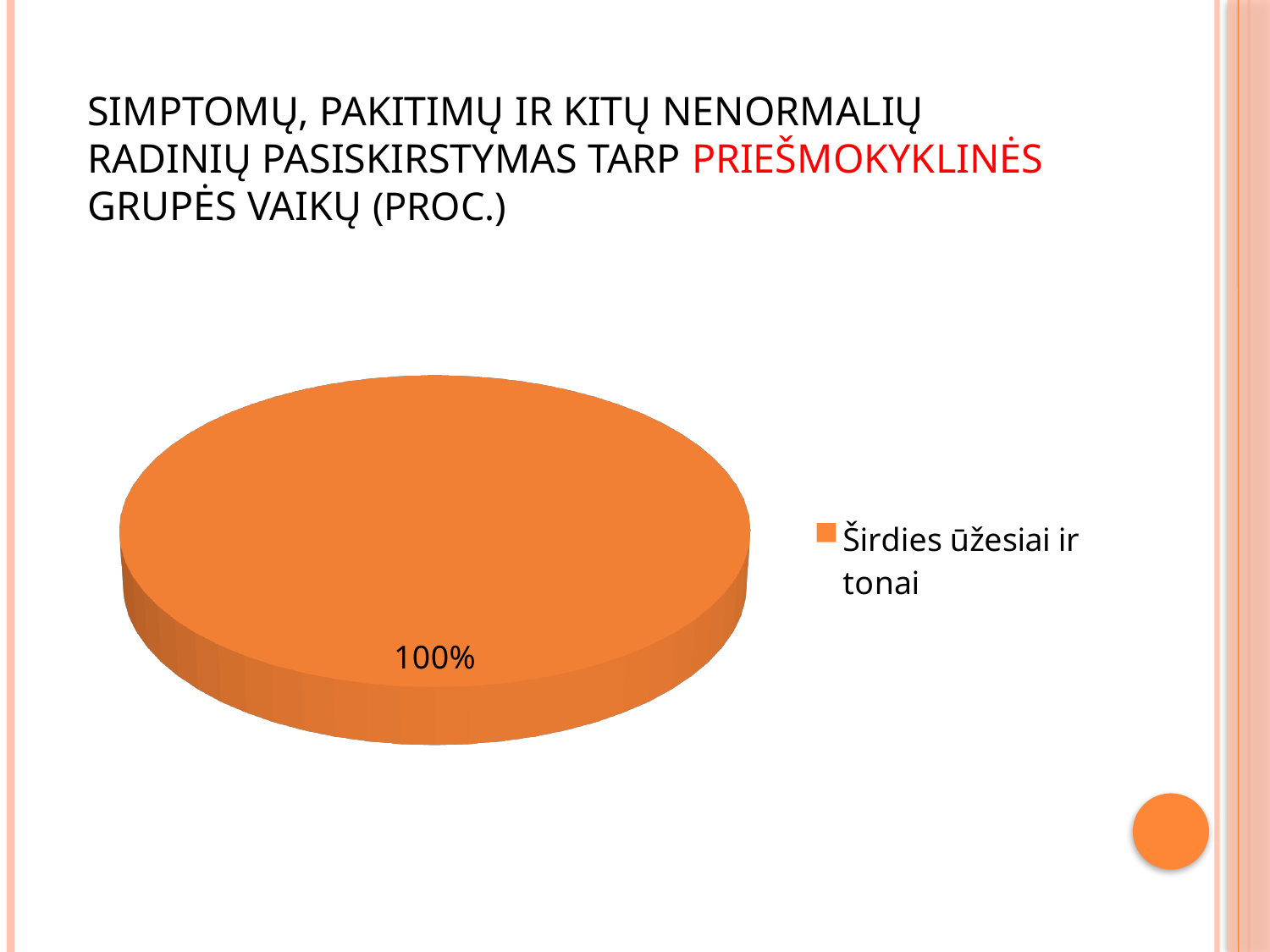
What colour is the pie slice? orange What kind of chart is shown on the slide? pie chart What share of the pie does "Širdies ūžesiai ir tonai" represent? 100% What is the legend entry for the pie chart? Širdies ūžesiai ir tonai Which category makes up the entire pie? Širdies ūžesiai ir tonai How many entries does the legend list? 1 How many slices does the pie chart have? 1 What value is printed on the pie slice? 100%